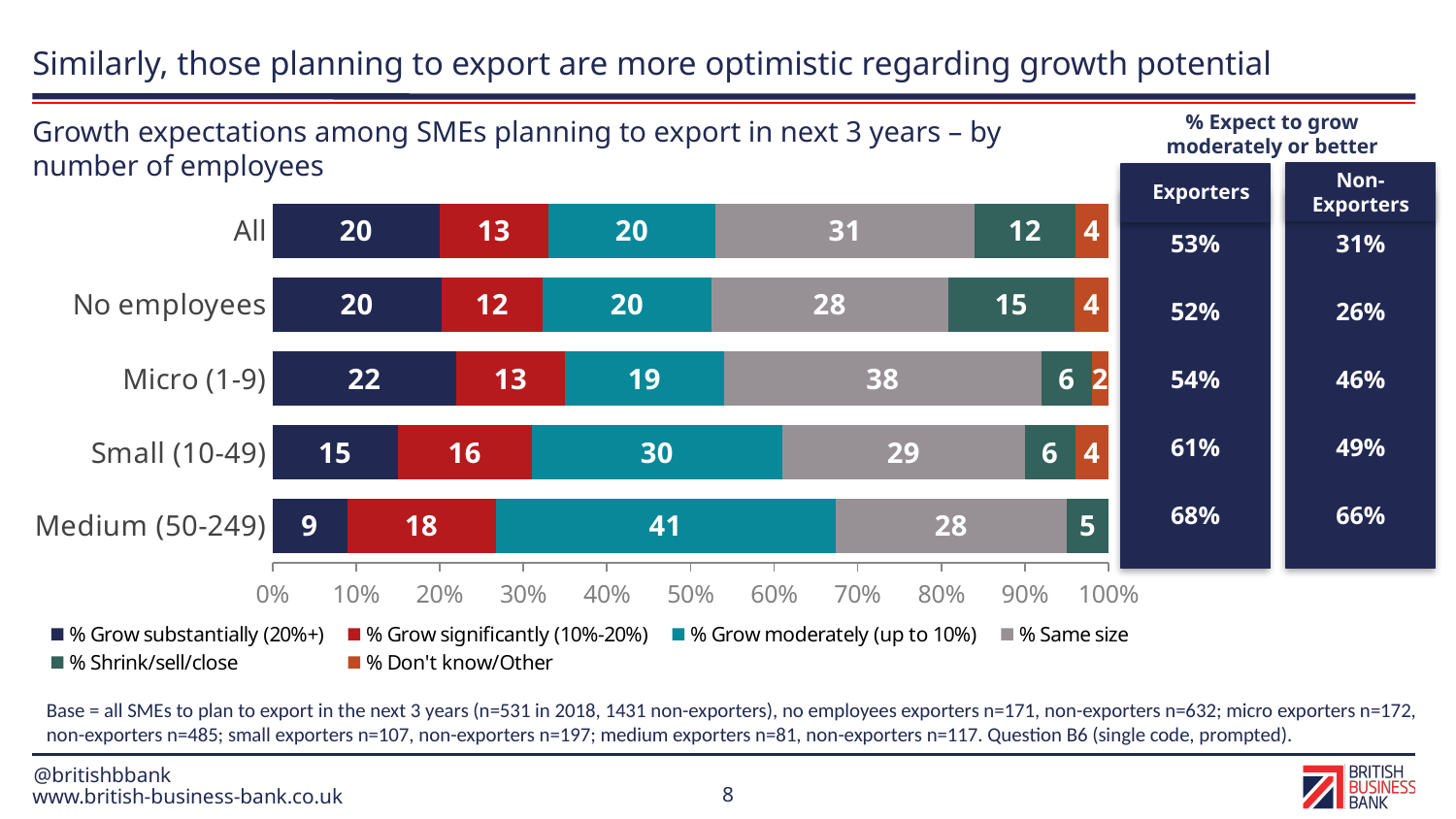
What is the value for % Same size for Micro (1-9)? 38 How many categories are shown on the chart? 5 What kind of chart is shown on the slide? Stacked bar chart What is the value for % Grow moderately (up to 10%) for Medium (50-249)? 41 What is the difference between the % Same size values for Micro (1-9) and Small (10-49)? 9 What is the value for % Grow substantially (20%+) for Small (10-49)? 15 How many series does the legend list? 6 What is the value for % Shrink/sell/close for No employees? 15 Which category has the lowest value for % Grow substantially (20%+)? Medium (50-249) Which has the larger value for % Grow significantly (10%-20%): Medium (50-249) or Small (10-49)? Medium (50-249) What is the title of the chart? Growth expectations among SMEs planning to export in next 3 years – by number of employees Which category has the highest value for % Grow substantially (20%+)? Micro (1-9)